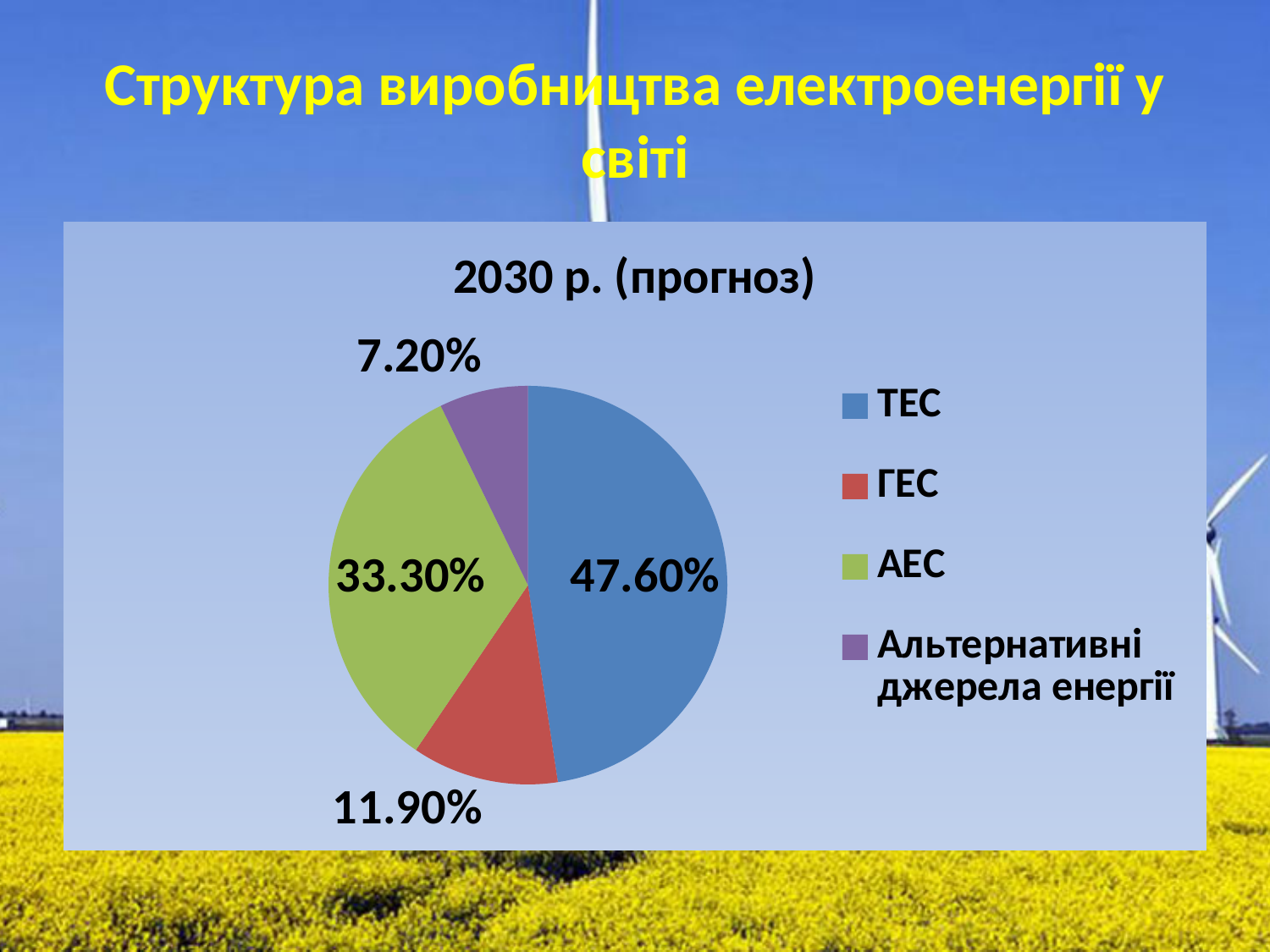
Which category has the smallest slice of the pie? Альтернативні джерела енергії What share of the pie does АЕС have? 33.30% What share of the pie do Альтернативні джерела енергії have? 7.20% What colour is the slice for АЕС? Green What share of the pie does ГЕС have? 11.90% Which is larger, the share of ГЕС or the share of Альтернативні джерела енергії? ГЕС What is the chart's title? 2030 р. (прогноз) What share of the pie does ТЕС have? 47.60% What is the difference between the shares of ТЕС and АЕС? 14.30% How many categories does the pie chart show? 4 What kind of chart is shown on the slide? Pie chart Which category has the largest slice of the pie? ТЕС